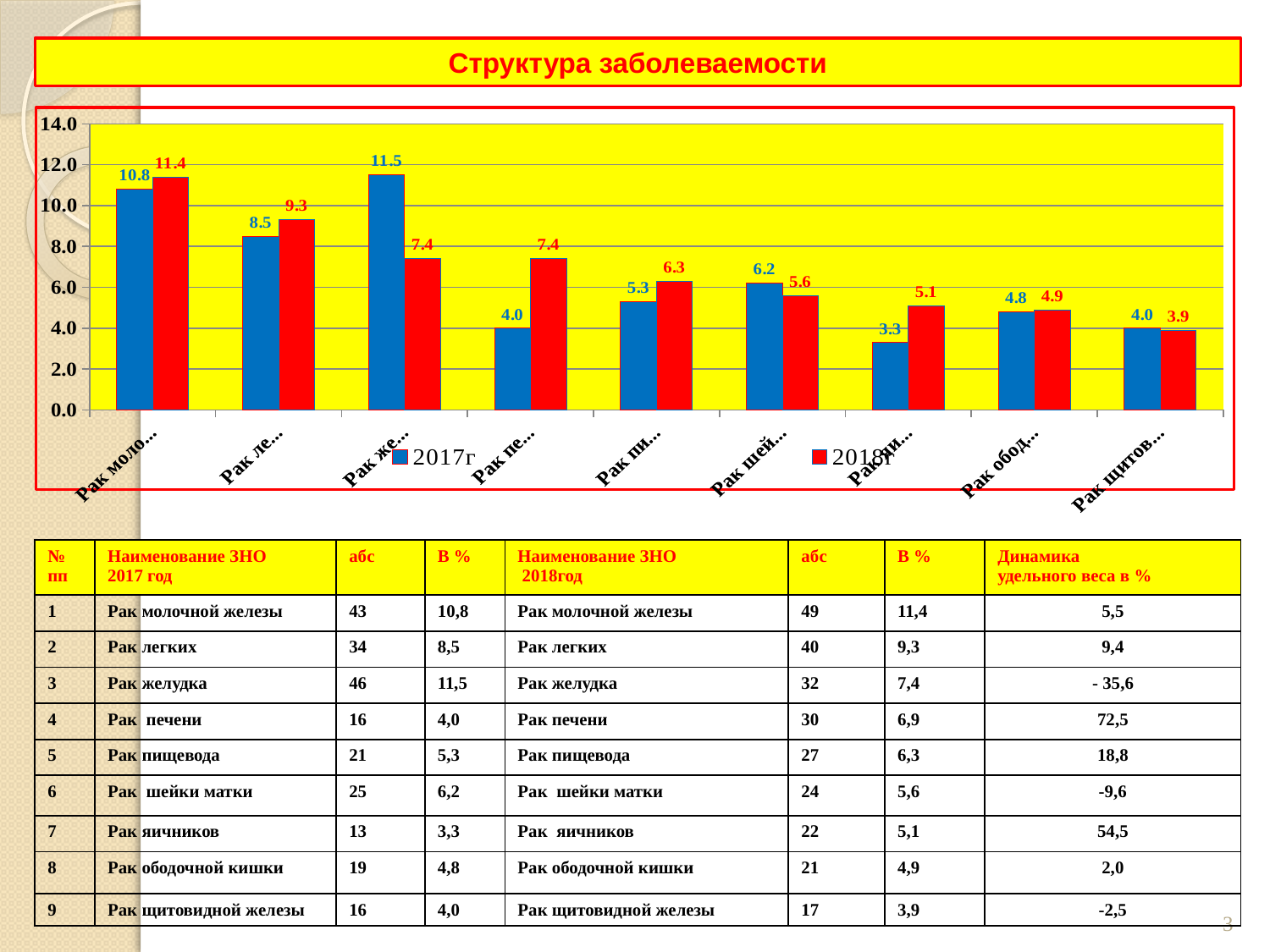
For Рак печени (the fourth category), which series has the larger value in the chart, 2017г or 2018г? 2018г Which category has the highest 2017г bar in the chart? Рак желудка Which category has the lowest 2018г bar in the chart? Рак щитовидной железы How many categories are shown on the x axis of the chart? 9 How many series does the chart legend list? 2 What is the 2017г value for Рак молочной железы (the first category) in the chart? 10.8 What type of chart is shown on the slide? Bar chart What is the 2018г value for Рак легких (the second category) in the chart? 9.3 What is the 2018г value for Рак желудка (the third category) in the chart? 7.4 By how much does the 2017г value for Рак желудка exceed its 2018г value in the chart? 4.1 Which category has the highest 2018г bar in the chart? Рак молочной железы Which category has the lowest 2017г bar in the chart? Рак яичников